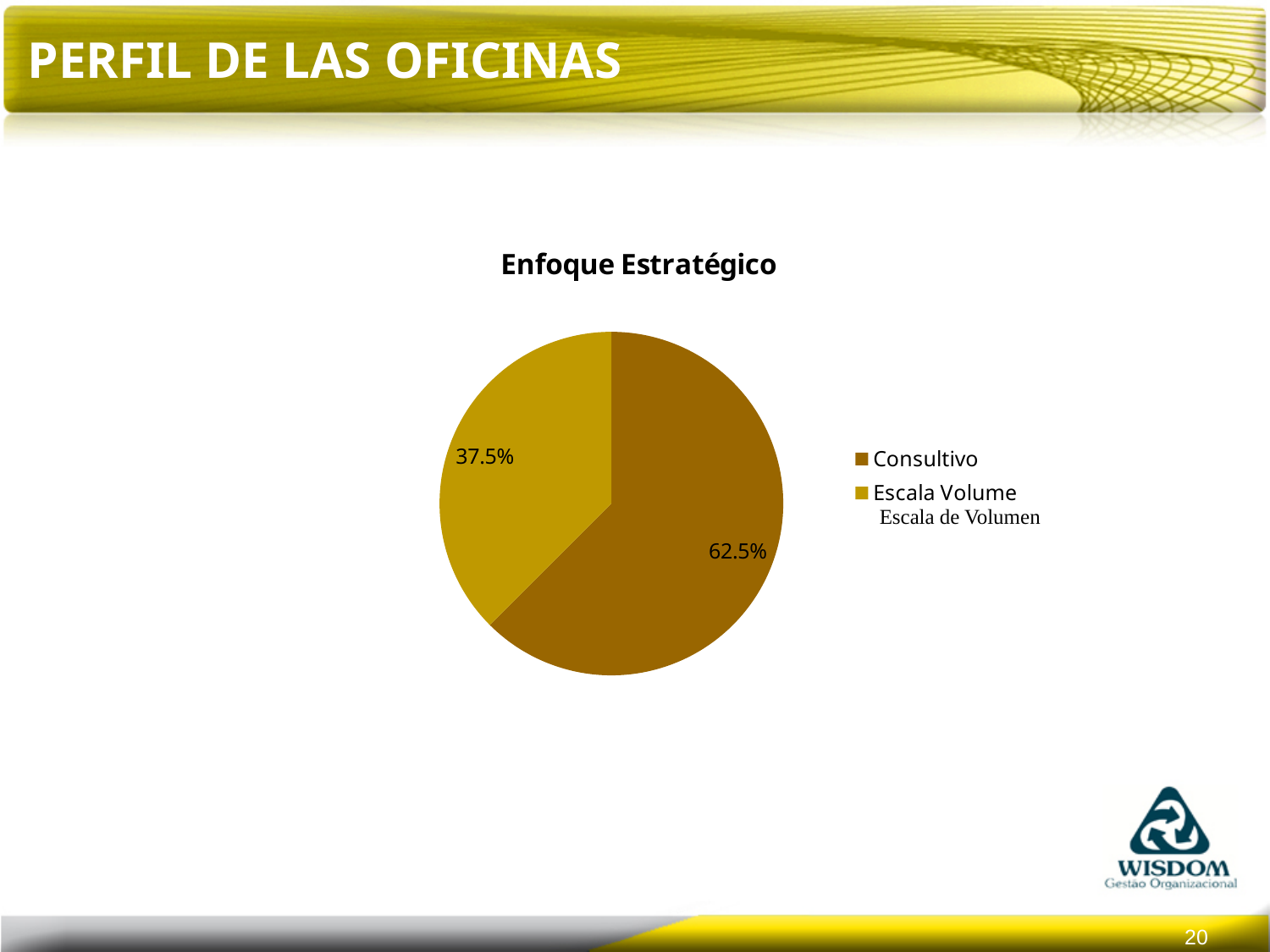
What kind of chart is shown on the slide? pie chart How many entries does the legend list? 2 What share of the pie does Escala Volume have? 37.5% Is the share for Consultivo greater or less than 50%? greater Which category has the largest slice of the pie? Consultivo What is the difference in percentage points between the Consultivo and Escala Volume slices? 25 Which is larger, the Consultivo slice or the Escala Volume slice? Consultivo What is the title of the chart? Enfoque Estratégico Which category has the smallest slice of the pie? Escala Volume What share of the pie does Consultivo have? 62.5% Which legend entry is shown in the lighter yellow colour? Escala Volume How many slices does the pie chart have? 2